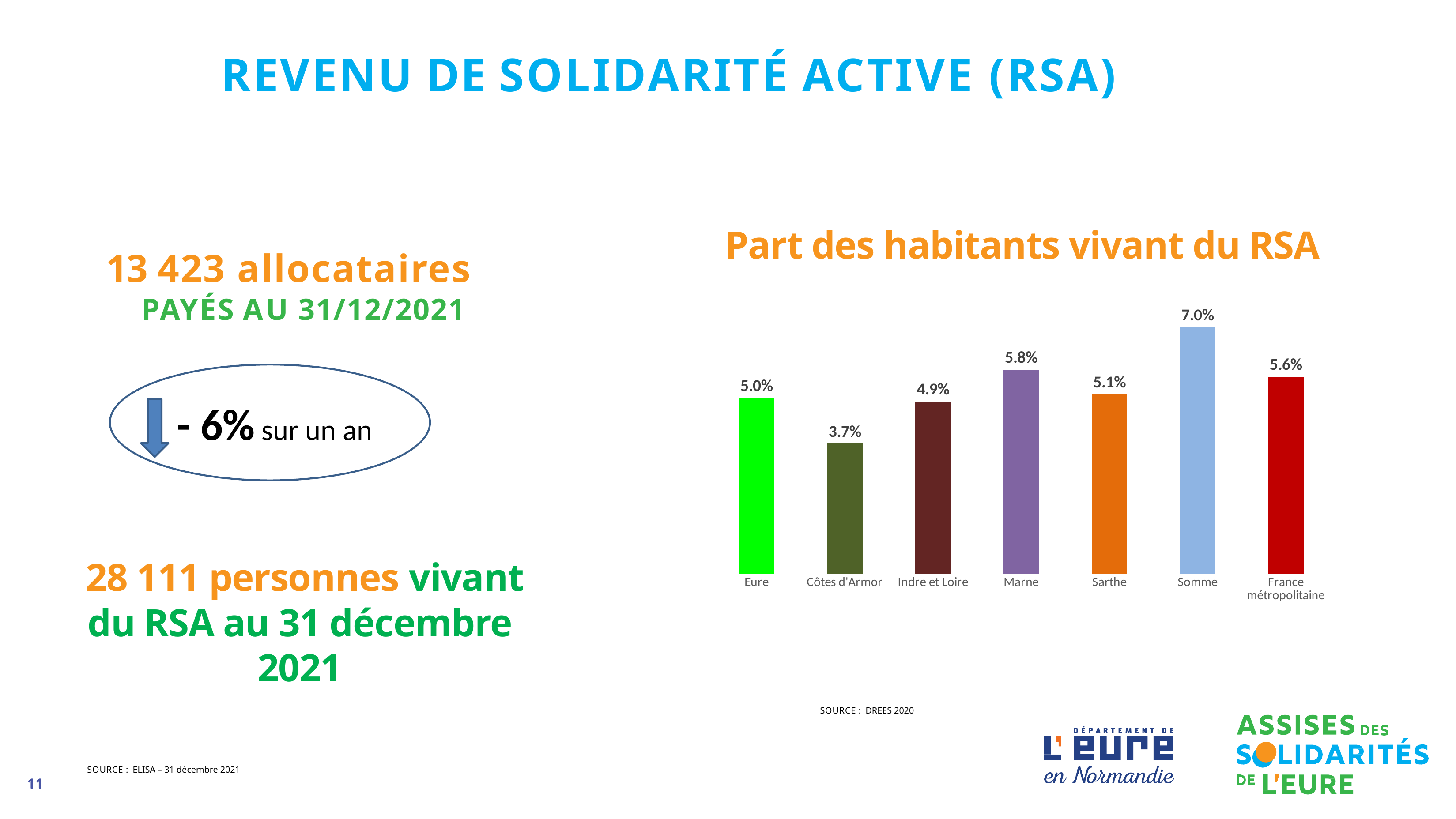
What is the title of the chart? Part des habitants vivant du RSA What is the difference between the values for Somme and Côtes d'Armor? 3.3% Which category has the lowest value in the chart? Côtes d'Armor What kind of chart is shown on the slide? Bar chart What is the value for Somme in the chart? 7.0% Which has a larger value, Marne or Sarthe? Marne Which category has the highest value in the chart? Somme What is the difference between the values for France métropolitaine and Eure? 0.6% What is the value for Eure in the chart? 5.0% What is the value for France métropolitaine in the chart? 5.6% How many categories are shown in the chart? 7 What is the value for Côtes d'Armor in the chart? 3.7%